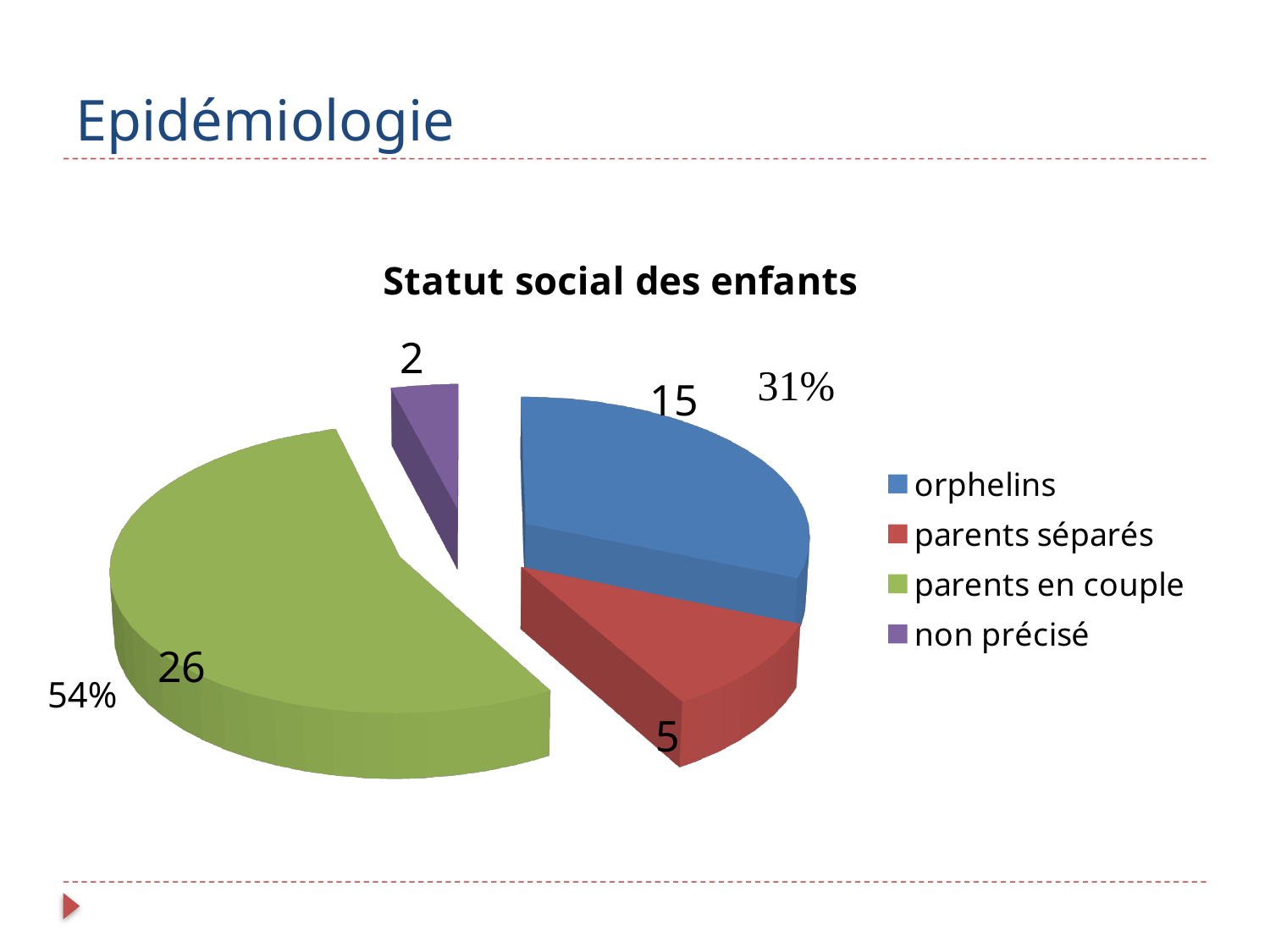
Which category has the smallest slice? non précisé What type of chart is shown on the slide? pie chart How many categories does the legend list? 4 What is the difference between the values for parents en couple and orphelins? 11 What is the value for orphelins? 15 Which category has the largest slice? parents en couple What is the value for parents en couple? 26 Which is larger, the value for orphelins or the value for parents séparés? orphelins What share of the pie does the parents en couple slice represent? 54% What is the title of the chart? Statut social des enfants What is the value for non précisé? 2 What is the value for parents séparés? 5